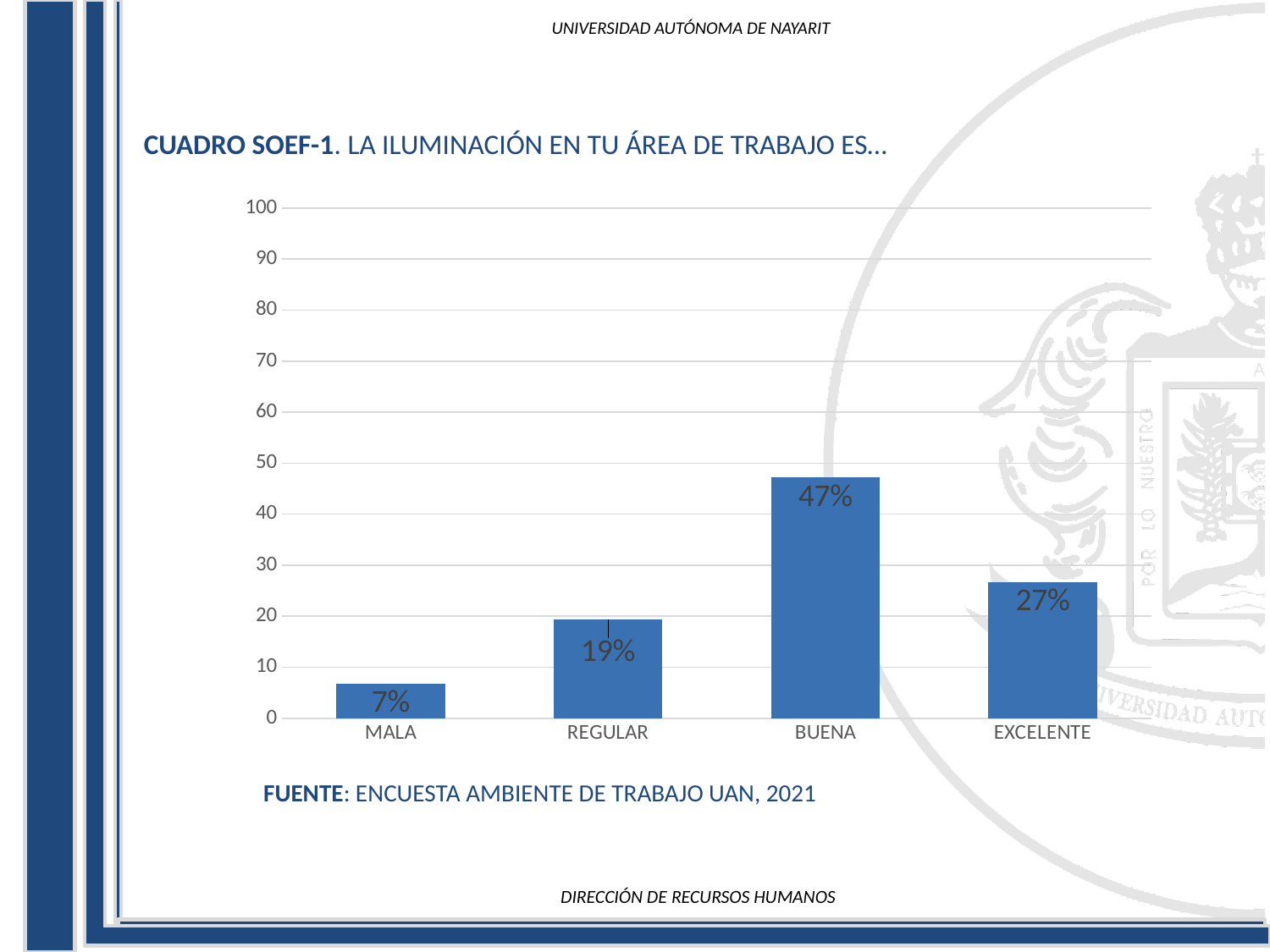
Which category has the highest value? BUENA What kind of chart is shown on the slide? bar chart What is the difference between the values for BUENA and EXCELENTE? 20% How many categories are shown on the x axis? 4 What is the value for BUENA? 47% What is the value for MALA? 7% Which category has the lowest value? MALA Is the value for BUENA greater or less than 50? less Which is larger, the value for REGULAR or the value for EXCELENTE? EXCELENTE What is the value for EXCELENTE? 27% What is the value for REGULAR? 19% What source is cited below the chart? ENCUESTA AMBIENTE DE TRABAJO UAN, 2021